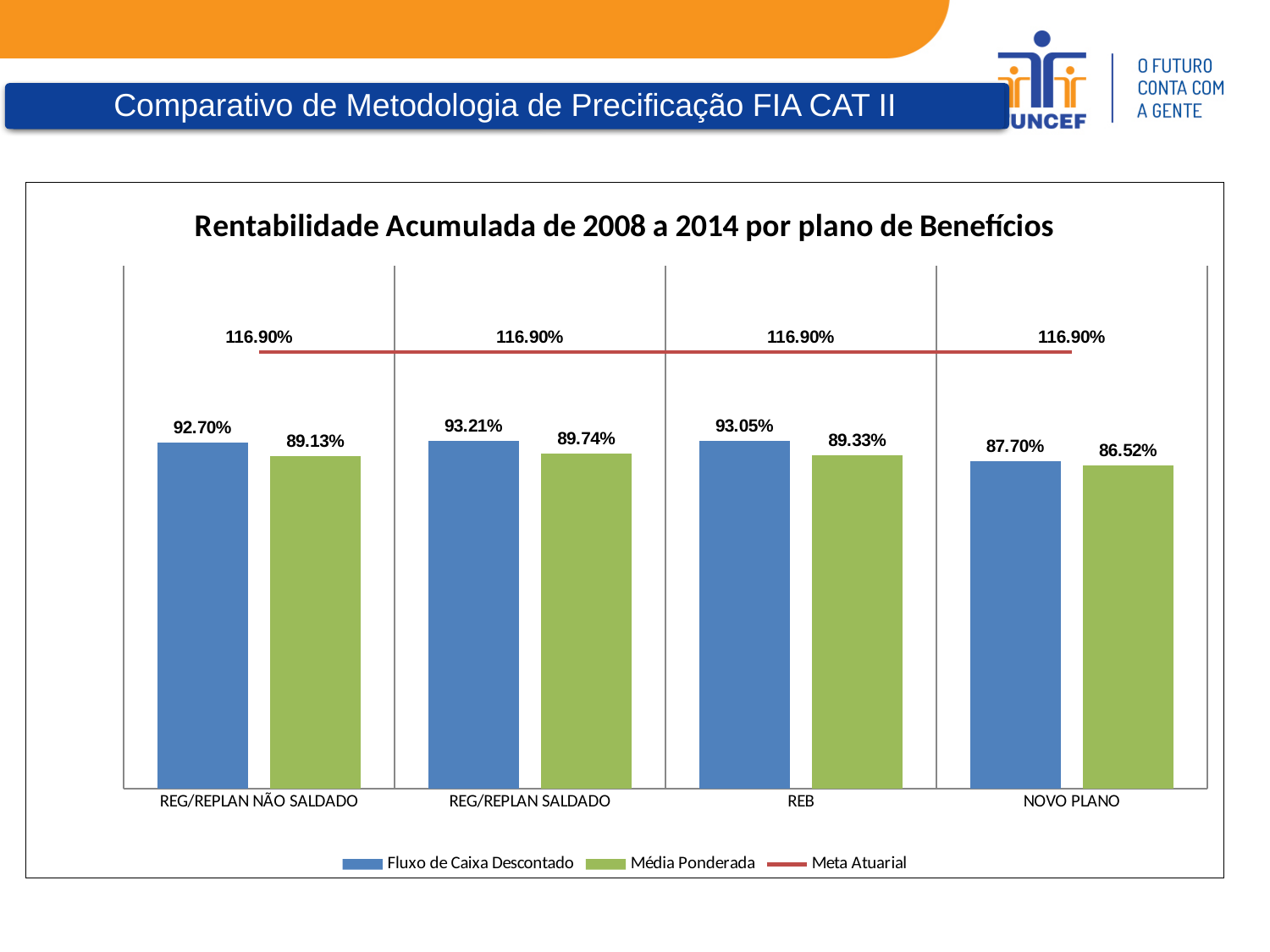
What is the value of the Meta Atuarial line? 116.90% Which plan has the lowest Média Ponderada value? NOVO PLANO How many plans (categories) are shown on the x axis? 4 What is the title of the chart? Rentabilidade Acumulada de 2008 a 2014 por plano de Benefícios What is the difference between the Meta Atuarial and the Fluxo de Caixa Descontado value for NOVO PLANO? 29.20% What is the value of Média Ponderada for REB? 89.33% How many series does the legend list? 3 Which plan has the highest Fluxo de Caixa Descontado value? REG/REPLAN SALDADO What is the value of Fluxo de Caixa Descontado for REG/REPLAN SALDADO? 93.21% What is the difference between Fluxo de Caixa Descontado and Média Ponderada for REG/REPLAN NÃO SALDADO? 3.57% What is the value of Média Ponderada for NOVO PLANO? 86.52% Which is larger for REB: Fluxo de Caixa Descontado or Média Ponderada? Fluxo de Caixa Descontado